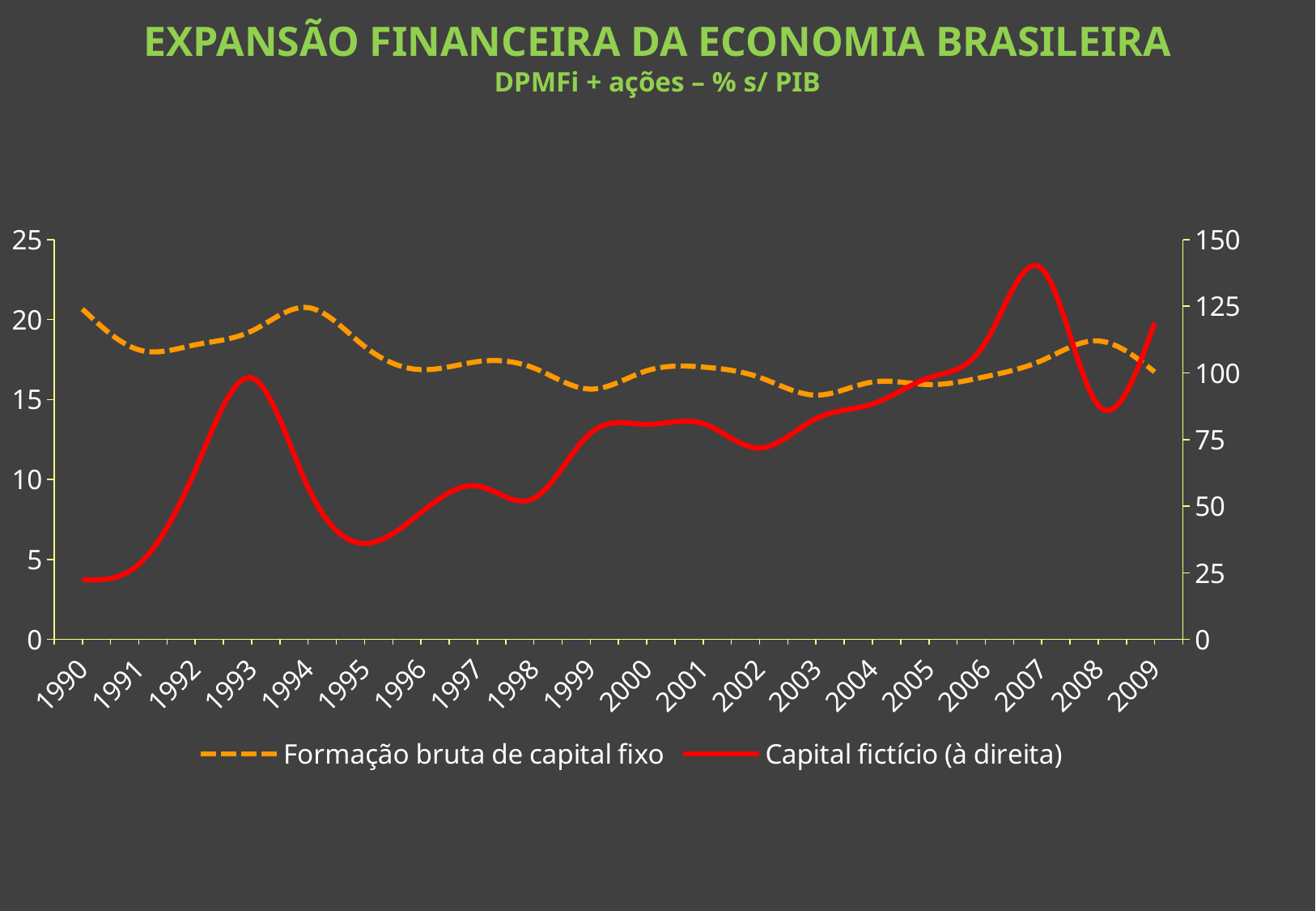
How many series does the legend list? 2 Is the value for Capital fictício in 1990 greater or less than 25? less Is the value for Formação bruta de capital fixo in 2003 greater or less than 20? less Is the value for Capital fictício in 2007 greater or less than 125? greater Does the Capital fictício series rise or fall from 1990 to 1993? rise How many years are plotted along the x axis? 20 Which series is plotted against the right-hand axis according to the legend? Capital fictício (à direita) What kind of chart is shown on the slide? line chart Which is larger for Capital fictício: the value in 2007 or the value in 2008? 2007 In which year is the Capital fictício series at its lowest value? 1990 In which year does the Capital fictício series reach its highest value? 2007